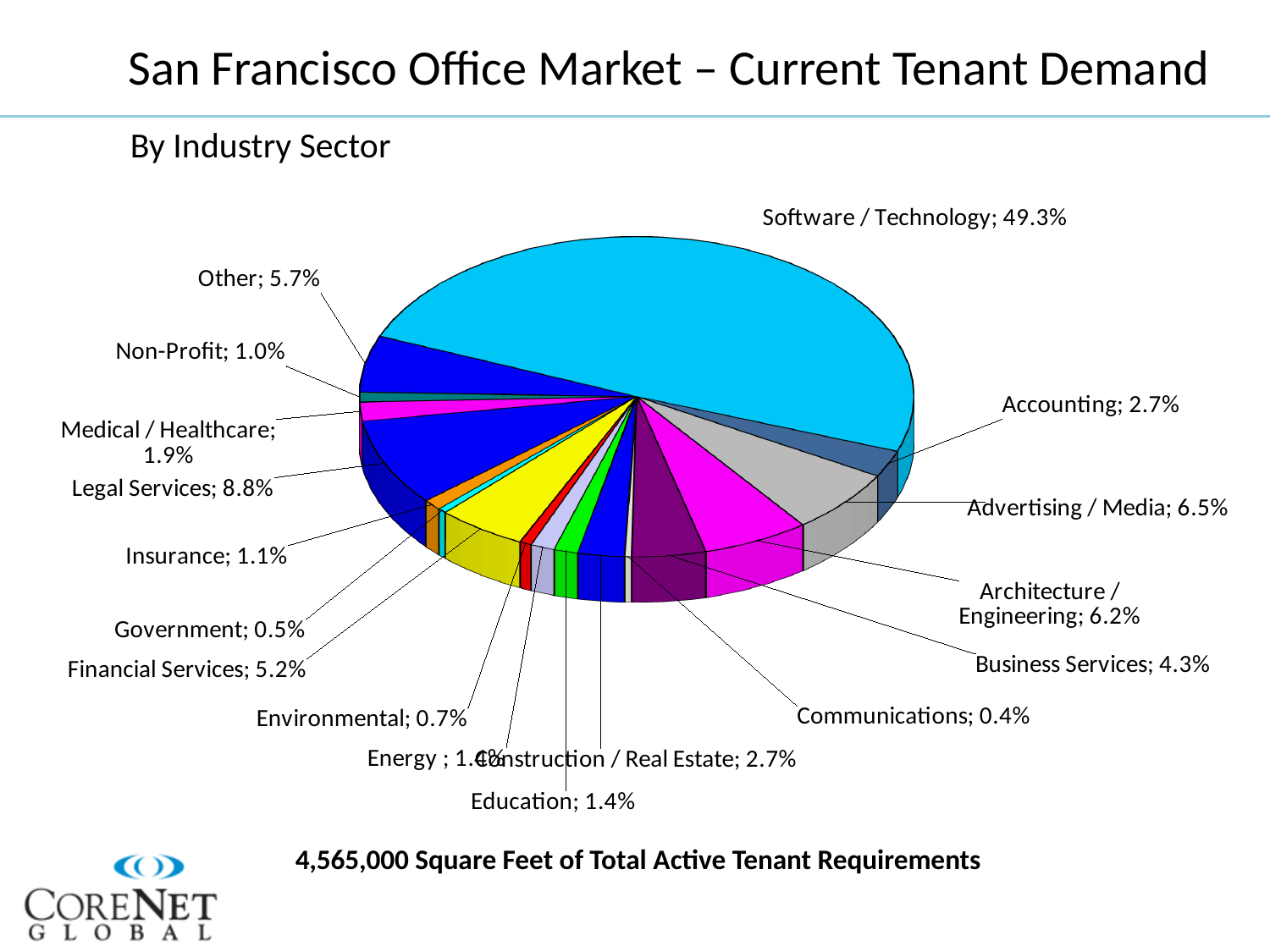
What percentage is shown for Financial Services? 5.2% What share of current tenant demand is Software / Technology? 49.3% What is the value shown for Advertising / Media? 6.5% Which has a larger share, Other or Financial Services? Other Which has a larger share, Architecture / Engineering or Business Services? Architecture / Engineering What total square footage of active tenant requirements is stated below the chart? 4,565,000 Square Feet How many industry sectors are shown in the pie chart? 17 Which industry sector has the largest share of the pie? Software / Technology Which industry sector has the smallest share of the pie? Communications What is the difference in percentage points between Legal Services and Advertising / Media? 2.3 What percentage does Legal Services account for? 8.8% What type of chart is shown on the slide? Pie chart